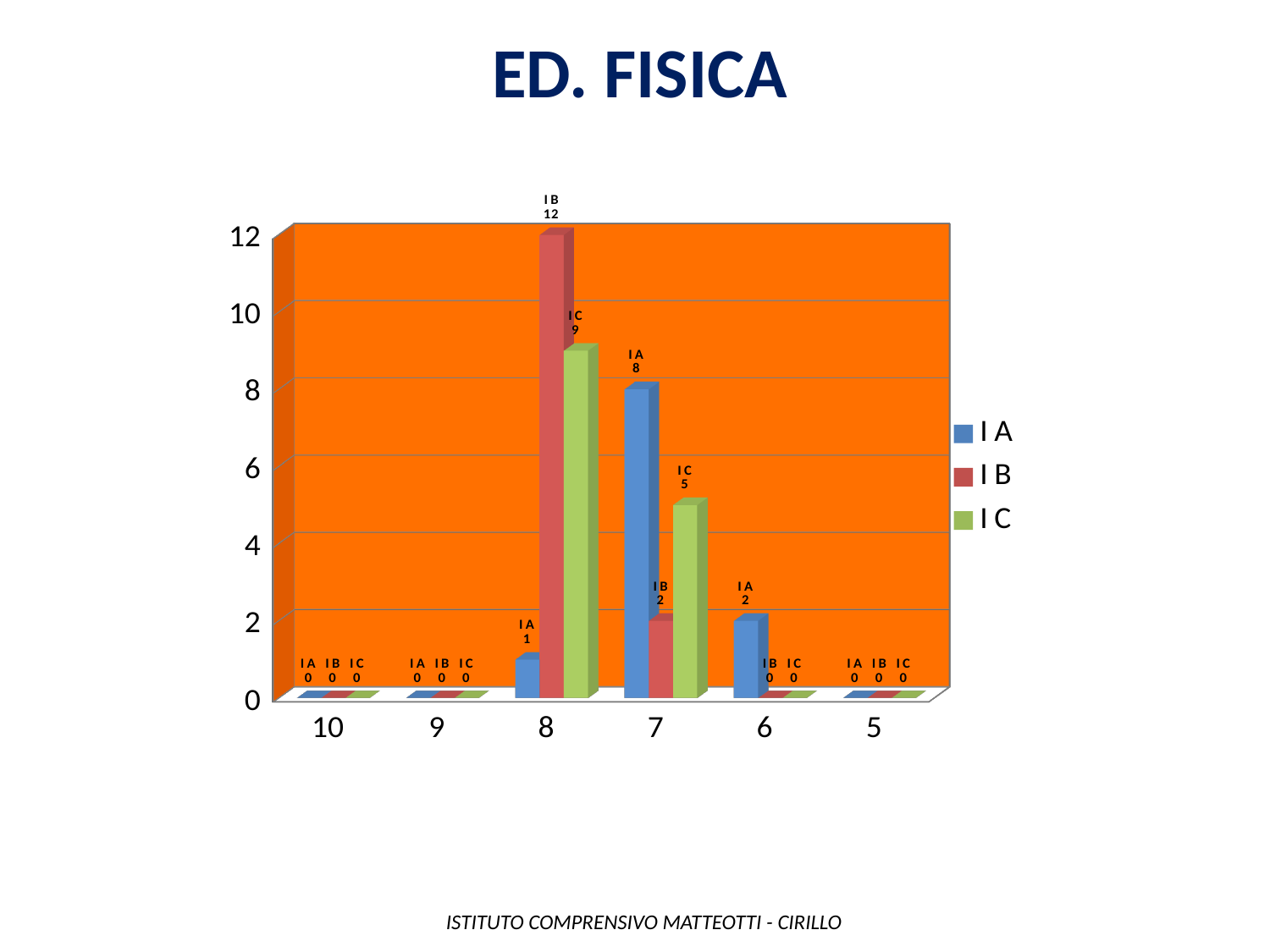
How many categories are shown on the x axis? 6 Which series has the highest value at category 8? I B What is the value for I C at category 7? 5 Which series has the lowest value at category 7? I B What is the value for I B at category 8? 12 What kind of chart is shown on the slide? bar chart What is the value for I A at category 8? 1 How many series does the legend list? 3 Which is larger at category 7: the value for I A or the value for I C? I A What is the title of the chart? ED. FISICA What is the difference between the I B and I C values at category 8? 3 What is the value for I A at category 6? 2